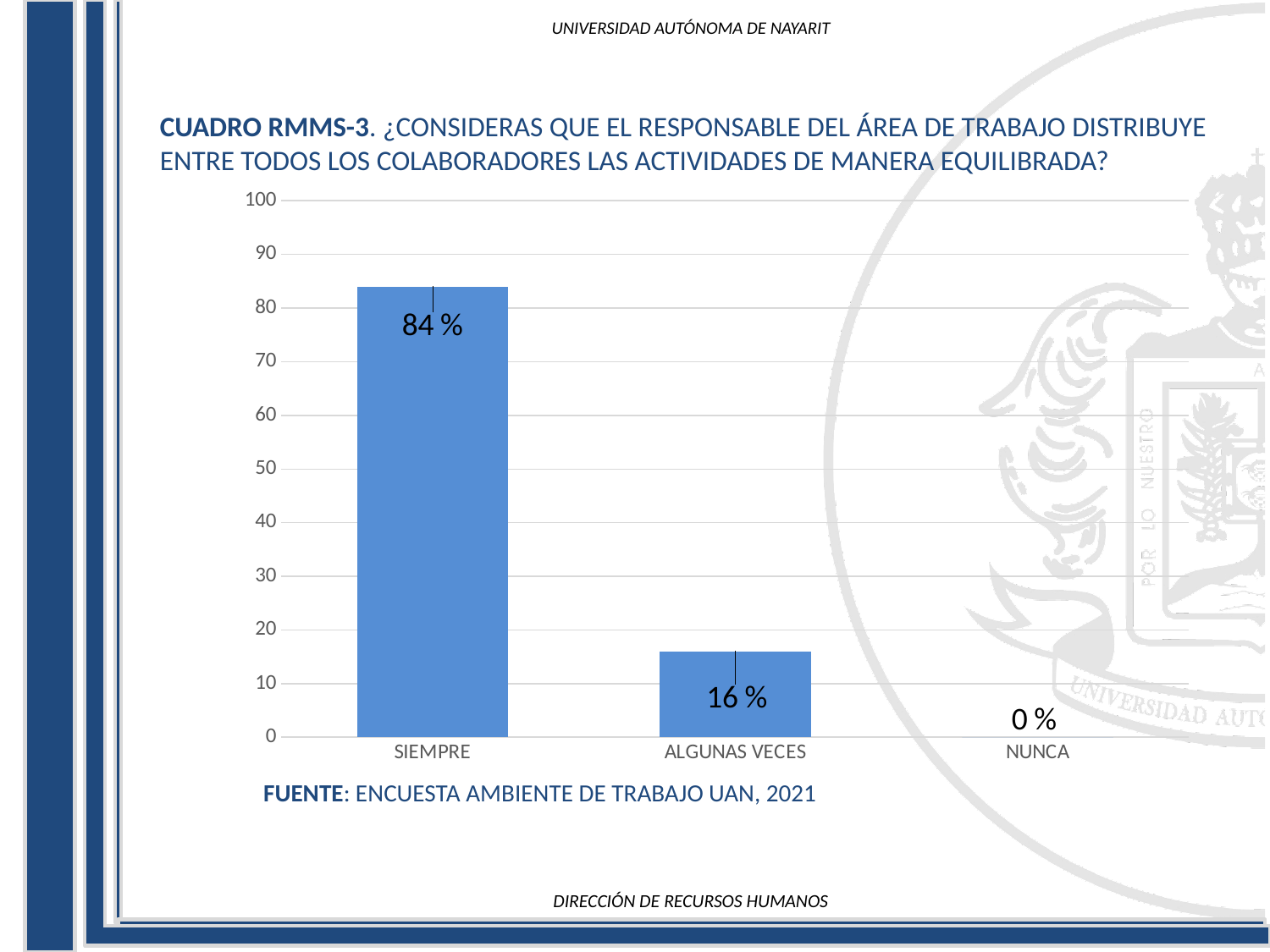
What is the value for SIEMPRE? 84 % What is the source cited below the chart? ENCUESTA AMBIENTE DE TRABAJO UAN, 2021 Which is larger, the value for ALGUNAS VECES or the value for NUNCA? ALGUNAS VECES Which category has the highest value? SIEMPRE What is the value for NUNCA? 0 % What is the value for ALGUNAS VECES? 16 % Is the value for SIEMPRE greater or less than 80? greater What is the difference between the values for SIEMPRE and ALGUNAS VECES? 68 % Which category has the lowest value? NUNCA What kind of chart is shown on the slide? bar chart Is the value for ALGUNAS VECES greater or less than 20? less How many categories are shown on the x axis? 3